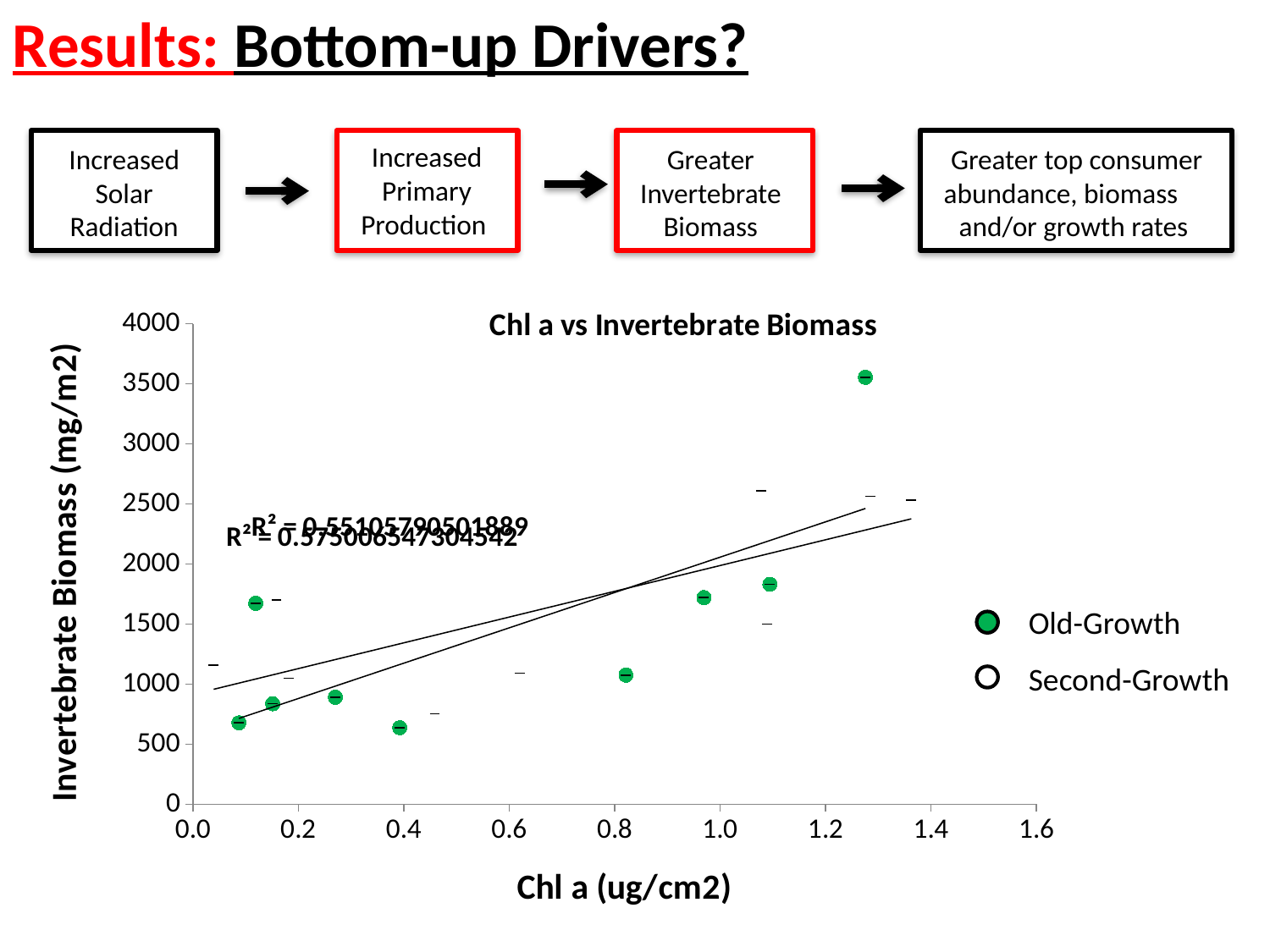
What is the maximum value shown on the y axis of the chart? 4000 How many Old-Growth (green filled) points are plotted on the chart? 9 Is the Old-Growth point at about 1.1 ug/cm2 Chl a greater or less than 1500 mg/m2? greater How many series does the legend of the chart list? 2 What kind of chart is shown on the slide? Scatter chart What are the two series named in the chart legend? Old-Growth and Second-Growth What is the maximum value shown on the x axis of the chart? 1.6 Is the Old-Growth point at about 0.4 ug/cm2 Chl a greater or less than 1000 mg/m2? less Do the fitted trend lines on the chart rise or fall as Chl a increases? rise What is the title of the chart? Chl a vs Invertebrate Biomass Is the highest Old-Growth point on the chart greater or less than 3000 mg/m2? greater Which series contains the single highest invertebrate biomass point on the chart? Old-Growth